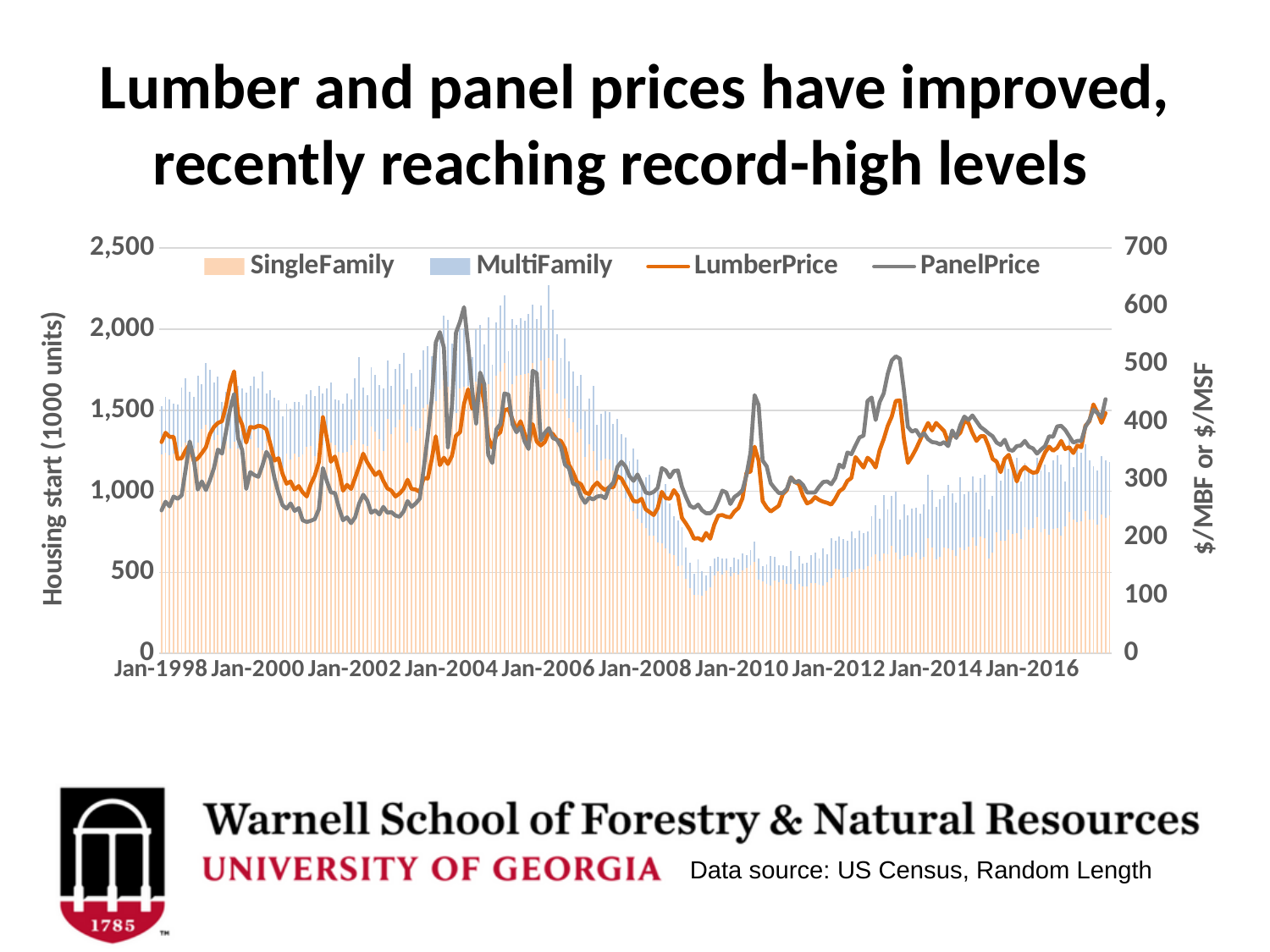
What kind of chart is shown on the slide? Combined bar and line chart Is the total housing starts (stacked bar) around Jan-2006 greater or less than 2,000? greater Does LumberPrice rise or fall between Jan-2009 and Jan-2013? rise Is the LumberPrice value around Jan-2009 greater or less than 300? less How many year labels are shown on the x axis? 10 Around Jan-2004, which is higher, PanelPrice or LumberPrice? PanelPrice How many series does the chart legend list? 4 Is the total housing starts (stacked bar) around Jan-2010 greater or less than 1,000? less Do total housing starts rise or fall between Jan-2006 and Jan-2009? fall What is the label of the right-hand vertical axis? $/MBF or $/MSF Which series are plotted as bars in the chart? SingleFamily and MultiFamily